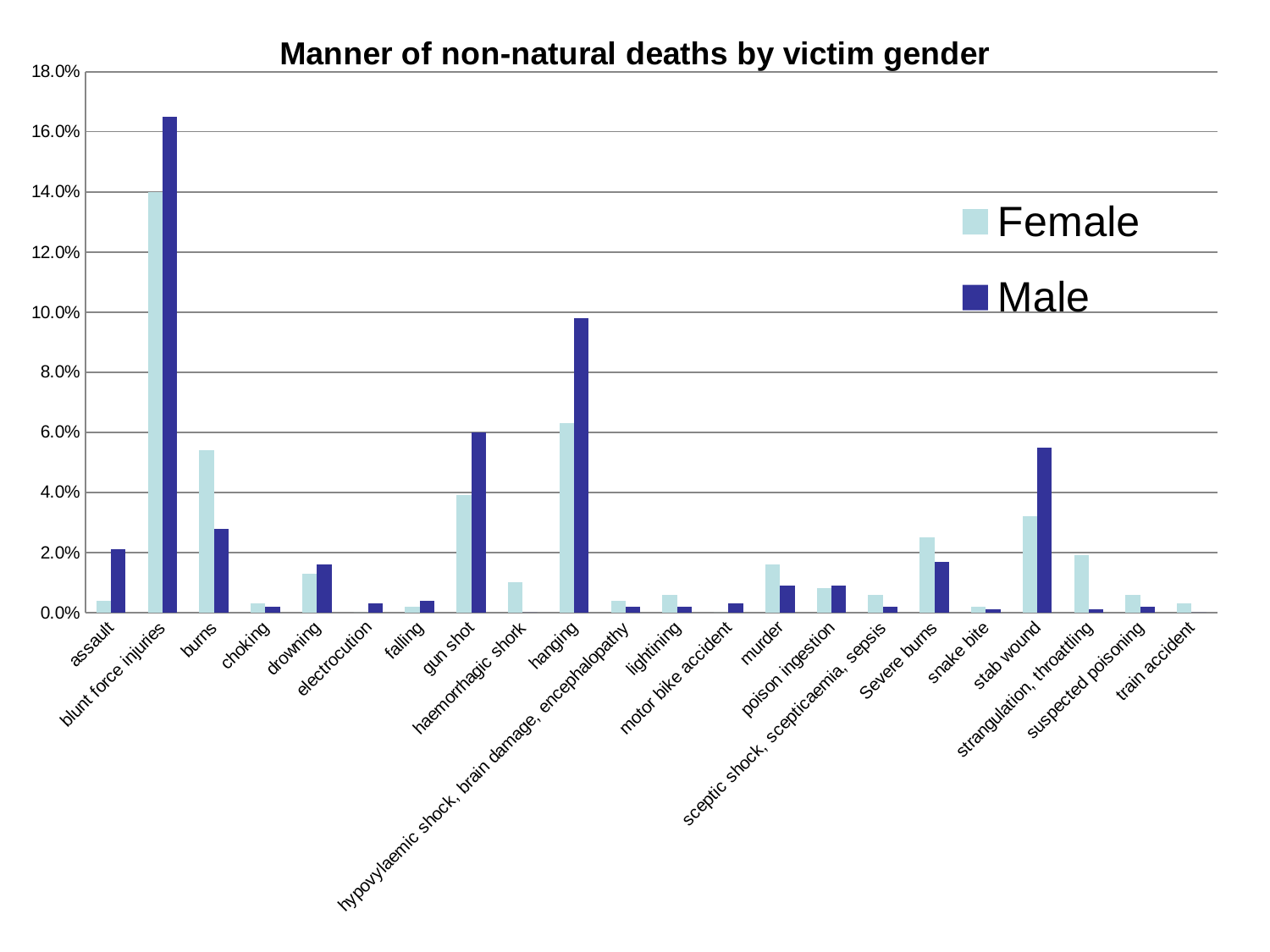
For burns, which is larger, the Female value or the Male value? Female Which category has the highest Female value? blunt force injuries How many series does the legend list? 2 What kind of chart is shown on the slide? bar chart Which category has the highest Male value? blunt force injuries Is the Female value for Severe burns greater or less than 4.0%? less Is the Male value for blunt force injuries greater or less than 16.0%? greater Is the Male value for stab wound greater or less than 4.0%? greater What is the title of the chart? Manner of non-natural deaths by victim gender How many categories are shown along the x axis? 22 For hanging, which is larger, the Female value or the Male value? Male